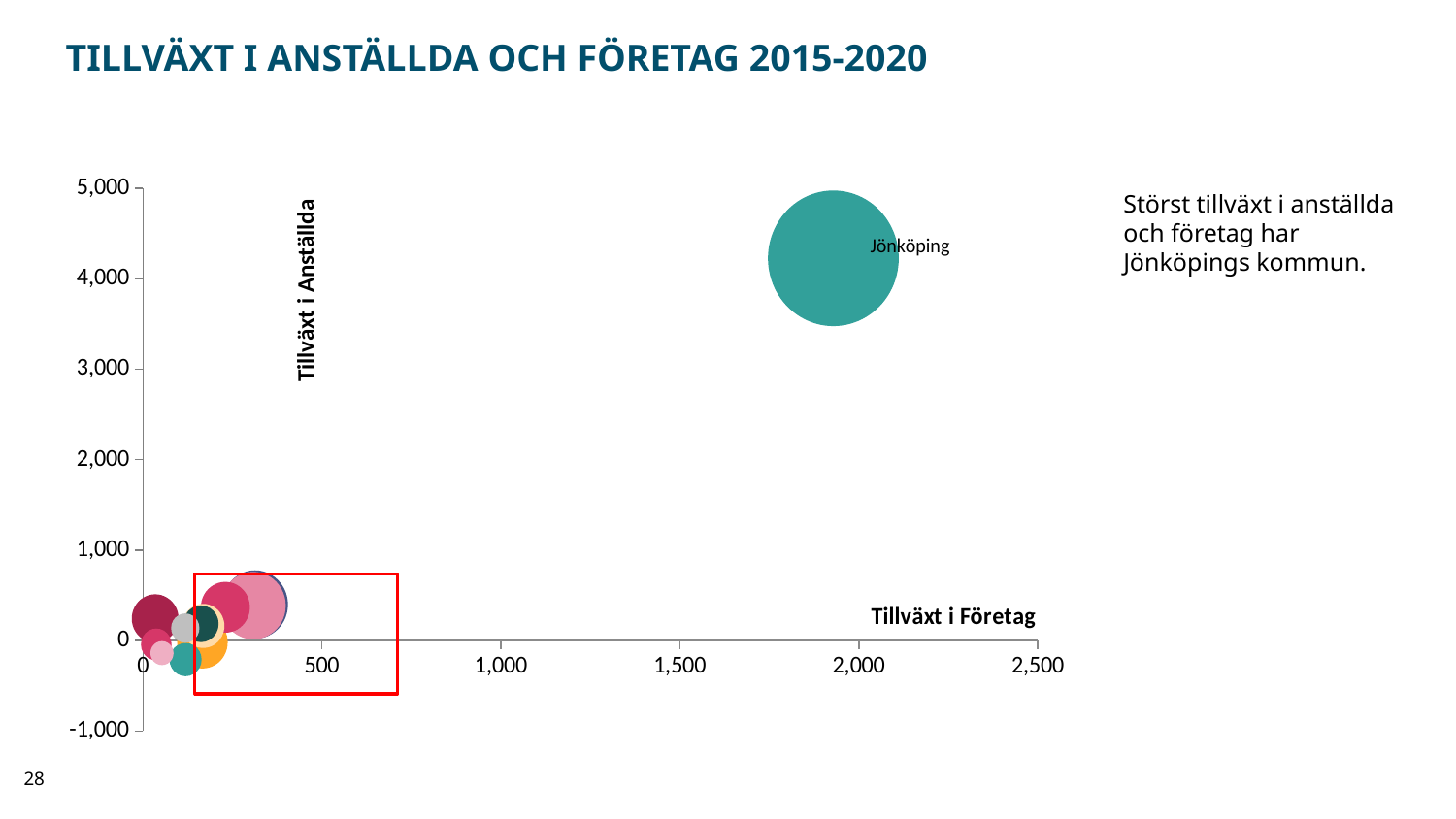
Is the Tillväxt i Företag value for Jönköping greater or less than 2,500? less What is the title of the chart on the slide? TILLVÄXT I ANSTÄLLDA OCH FÖRETAG 2015-2020 Which labelled point lies highest on the vertical axis (Tillväxt i Anställda)? Jönköping Is the Tillväxt i Anställda value for Jönköping greater or less than 3,000? greater What is the label of the horizontal axis? Tillväxt i Företag Which municipality is named as having the largest growth in employees and companies? Jönköping What is the highest value shown on the vertical axis? 5,000 What kind of chart is shown on the slide? Bubble chart Is the Tillväxt i Anställda value for Jönköping greater or less than 5,000? less Which point is furthest to the right on the horizontal axis (Tillväxt i Företag)? Jönköping